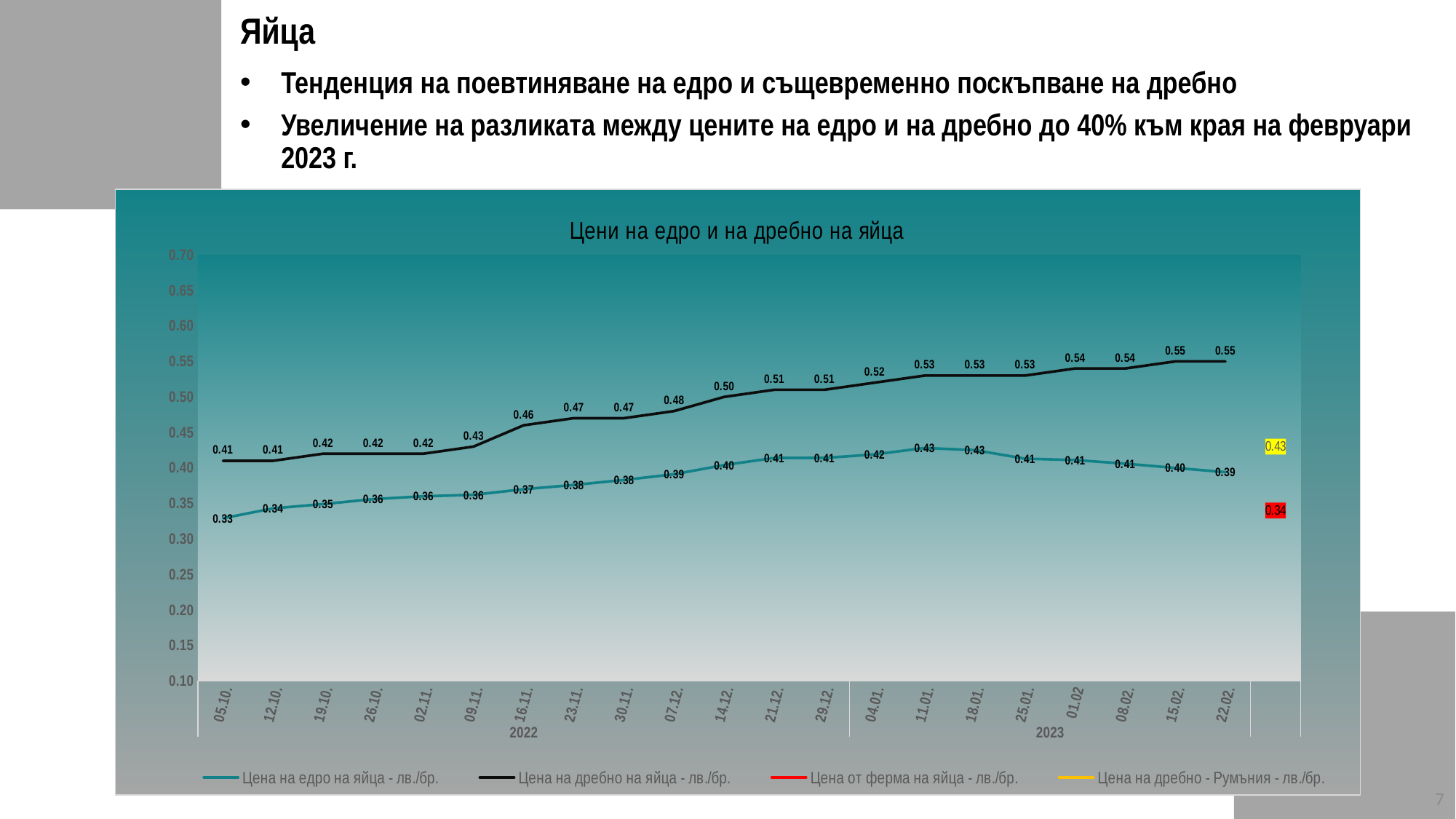
Which series has the higher value on 14.12., 'Цена на едро на яйца' or 'Цена на дребно на яйца'? Цена на дребно на яйца What is the value of 'Цена на едро на яйца - лв./бр.' on 11.01.? 0.43 What is the difference between the retail price ('Цена на дребно на яйца') and the wholesale price ('Цена на едро на яйца') on 22.02.? 0.16 What is the value of 'Цена на дребно на яйца - лв./бр.' on 16.11.? 0.46 What type of chart is shown on the slide? line chart How many dates are plotted along the x axis? 21 What is the value of 'Цена на дребно на яйца - лв./бр.' on 22.02.? 0.55 How many series does the chart legend list? 4 On which date does 'Цена на едро на яйца - лв./бр.' reach its lowest value? 05.10. What is the title of the chart? Цени на едро и на дребно на яйца Does 'Цена на дребно на яйца - лв./бр.' rise or fall from 05.10. to 22.02.? rise What is the value of 'Цена на едро на яйца - лв./бр.' on 05.10.? 0.33